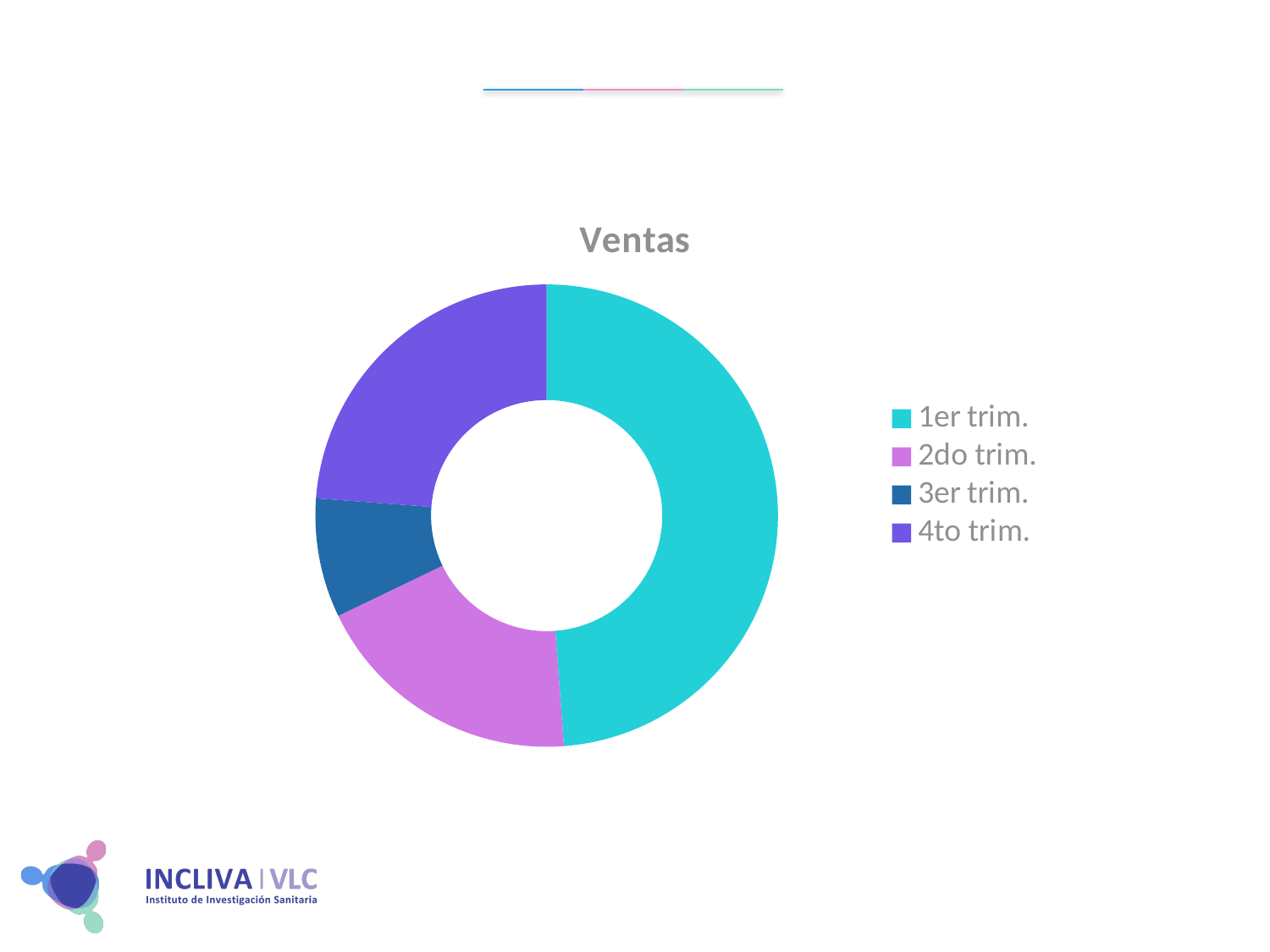
Which category has the smallest share of the chart? 3er trim. What kind of chart is shown on the slide? doughnut chart Which is larger, the share for 1er trim. or the share for 4to trim.? 1er trim. Which is larger, the share for 2do trim. or the share for 3er trim.? 2do trim. How many entries does the legend list? 4 What is the title of the chart? Ventas Which category has the largest share of the chart? 1er trim. How many categories does the chart show? 4 Which legend entry is shown in dark blue? 3er trim. Which is larger, the share for 1er trim. or the share for 2do trim.? 1er trim.